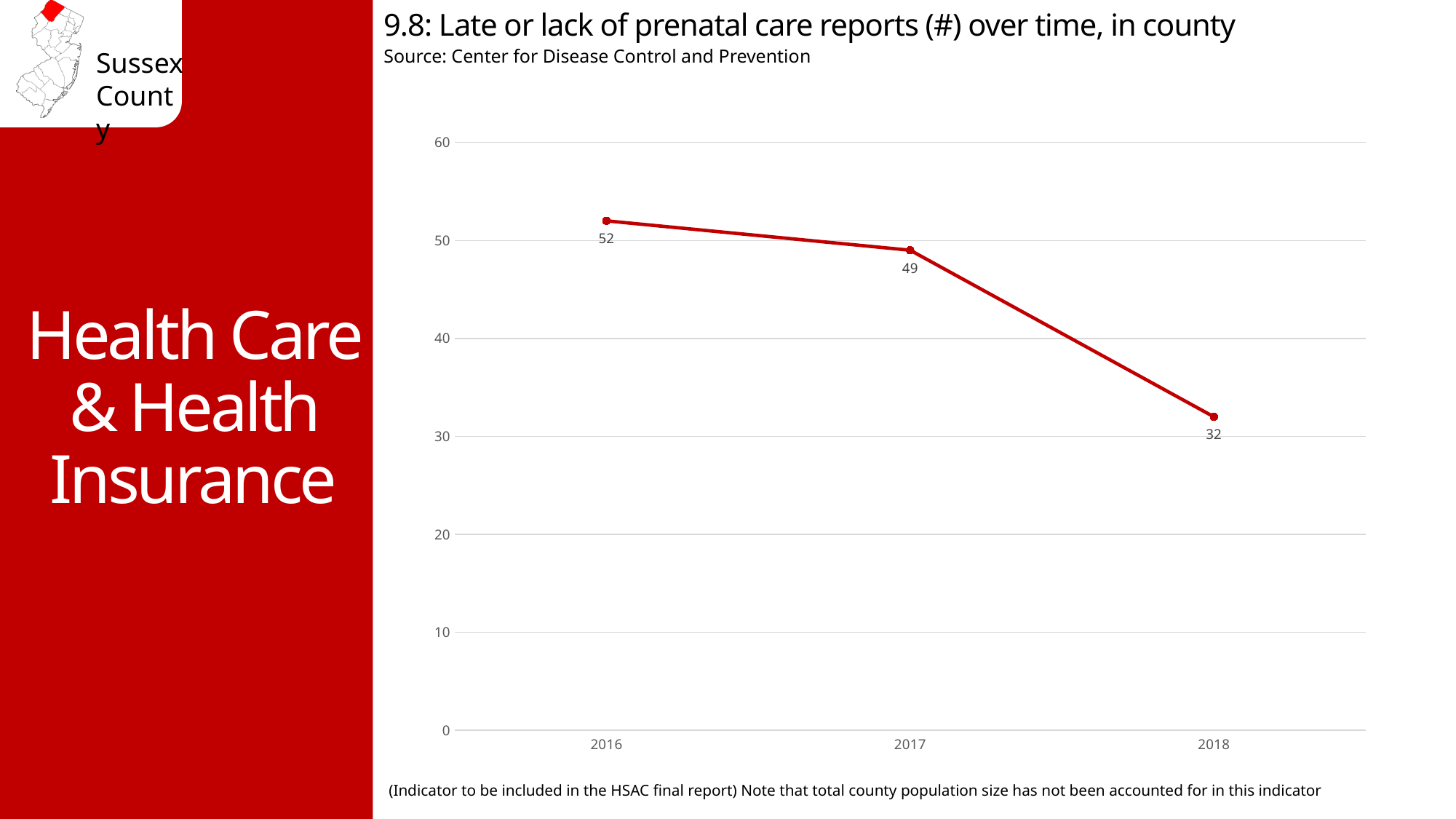
Which year has the lowest number of late or lack of prenatal care reports? 2018 How many years are plotted on the chart? 3 What is the number of late or lack of prenatal care reports in 2017? 49 Which year has the highest number of late or lack of prenatal care reports? 2016 What is the number of late or lack of prenatal care reports in 2016? 52 What is the difference between the number of reports in 2016 and 2018? 20 What kind of chart is shown on the slide? line chart Do the values rise or fall from 2016 to 2018? fall Which year has more late or lack of prenatal care reports, 2017 or 2018? 2017 What is the number of late or lack of prenatal care reports in 2018? 32 Is the value for 2018 greater or less than 40? less What is the difference between the number of reports in 2017 and 2018? 17